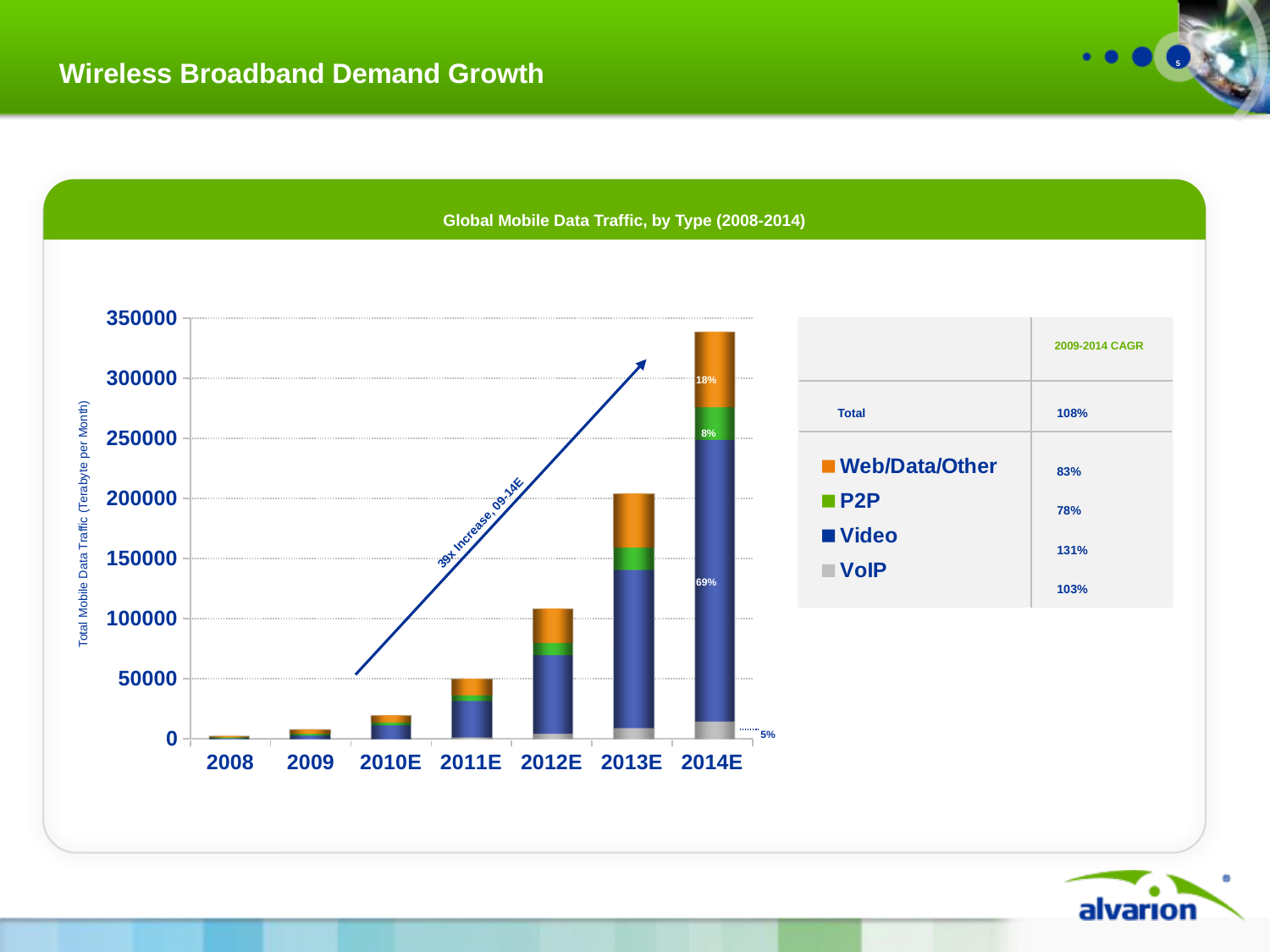
Which year has the highest total mobile data traffic in the chart? 2014E Is the total value for 2010E greater or less than 50000? less How many series does the chart's legend list? 4 What percentage label is shown on the Web/Data/Other segment of the 2014E bar? 18% What kind of chart is shown on the slide? Stacked bar chart Which year has the lowest total mobile data traffic in the chart? 2008 What is the title of the chart? Global Mobile Data Traffic, by Type (2008-2014) Is the total value for 2014E greater or less than 300000? greater How many years (categories) are shown on the x axis of the chart? 7 What percentage label is shown on the Video segment of the 2014E bar? 69% Do the total values rise or fall from 2008 to 2014E? rise